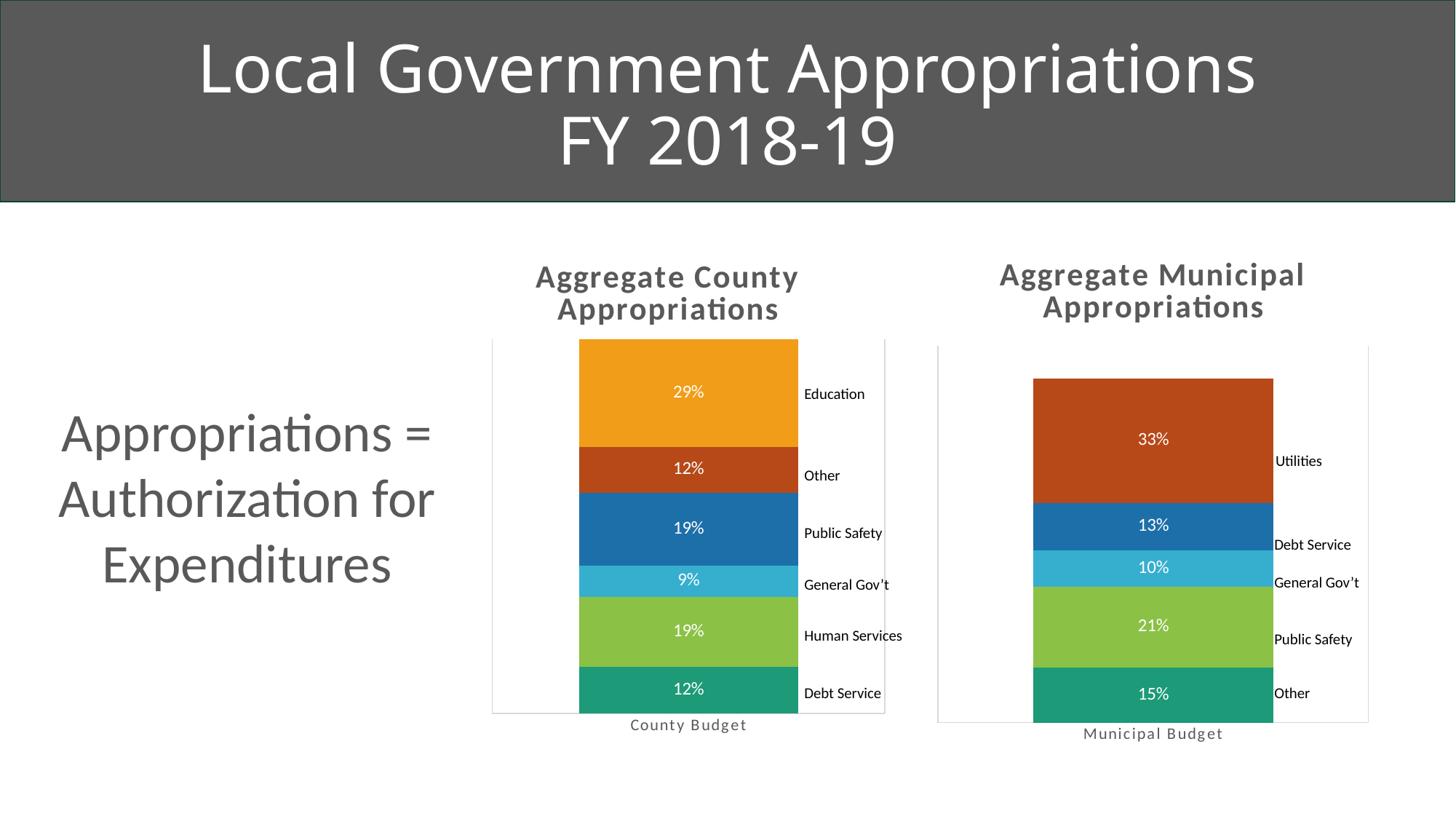
In the Aggregate County Appropriations chart, what is the value for General Gov't? 9% In the Aggregate County Appropriations chart, what share of the county budget goes to Education? 29% In the Aggregate County Appropriations chart, which category has the smallest share? General Gov't In the Aggregate Municipal Appropriations chart, what share of the municipal budget goes to Utilities? 33% In the Aggregate Municipal Appropriations chart, which category has the smallest share? General Gov't What type of chart is the Aggregate Municipal Appropriations chart? Stacked bar chart In the Aggregate Municipal Appropriations chart, what is the value for Public Safety? 21% Which is larger: Public Safety in the Aggregate County Appropriations chart or Public Safety in the Aggregate Municipal Appropriations chart? Municipal (21%) How many segments make up the stacked bar in the Aggregate County Appropriations chart? 6 In the Aggregate County Appropriations chart, what is the difference between Education and Debt Service? 17% In the Aggregate Municipal Appropriations chart, what is the difference between the Utilities share and the Debt Service share? 20% In the Aggregate County Appropriations chart, which category has the largest share? Education